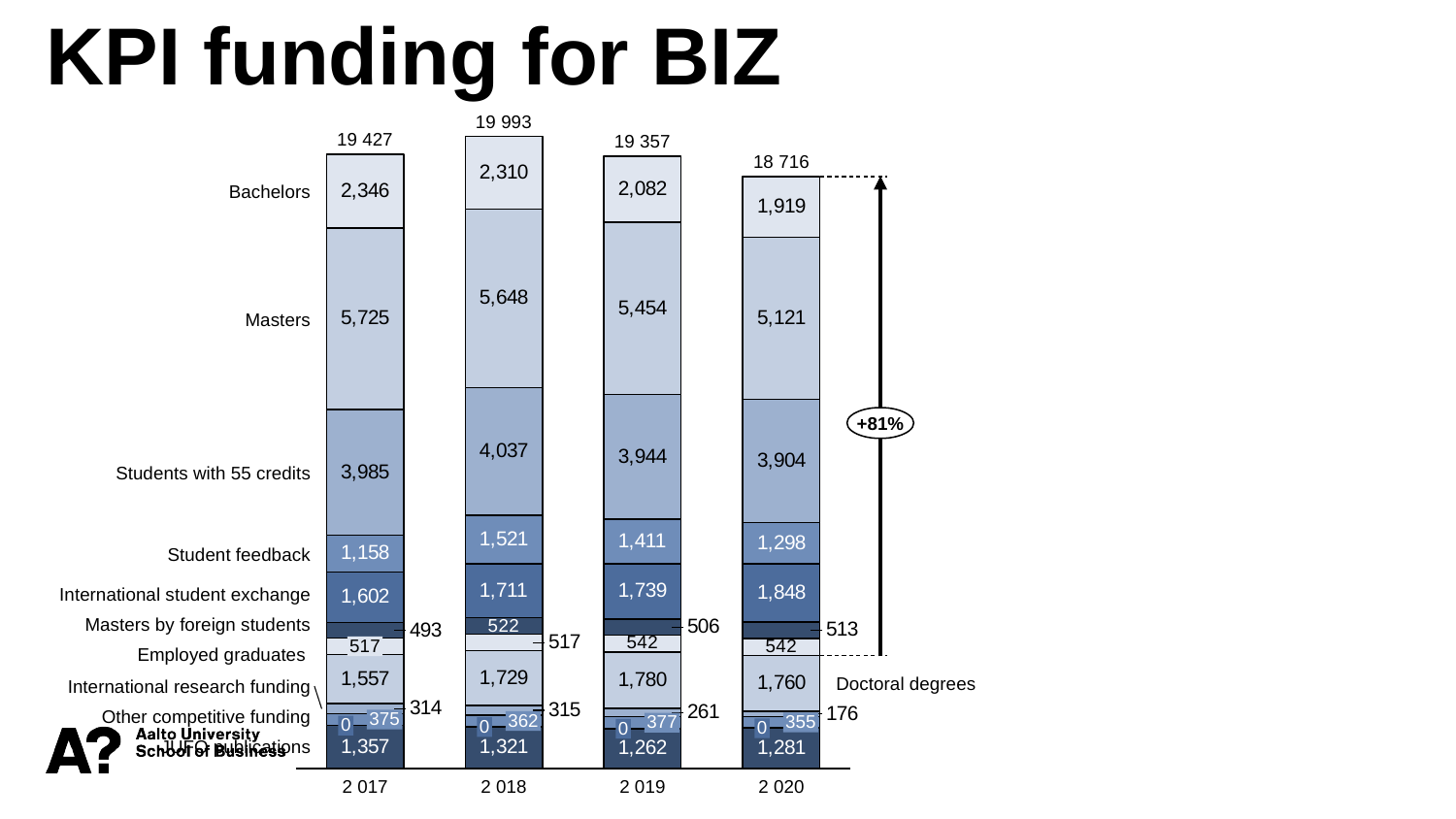
What kind of chart is shown on the slide? Stacked bar chart What is the total shown above the 2018 bar? 19 993 Which year has the larger International student exchange value, 2017 or 2020? 2 020 Do the Bachelors values rise or fall from 2017 to 2020? Fall What is the Student feedback value for 2019? 1,411 What is the Bachelors value for 2020? 1,919 Which year has the lowest total KPI funding? 2 020 Which year has the highest total KPI funding? 2 018 What is the Masters value for 2017? 5,725 What is the Students with 55 credits value for 2018? 4,037 What is the difference between the Masters value in 2017 and in 2020? 604 How many years are shown on the x axis of the chart? 4